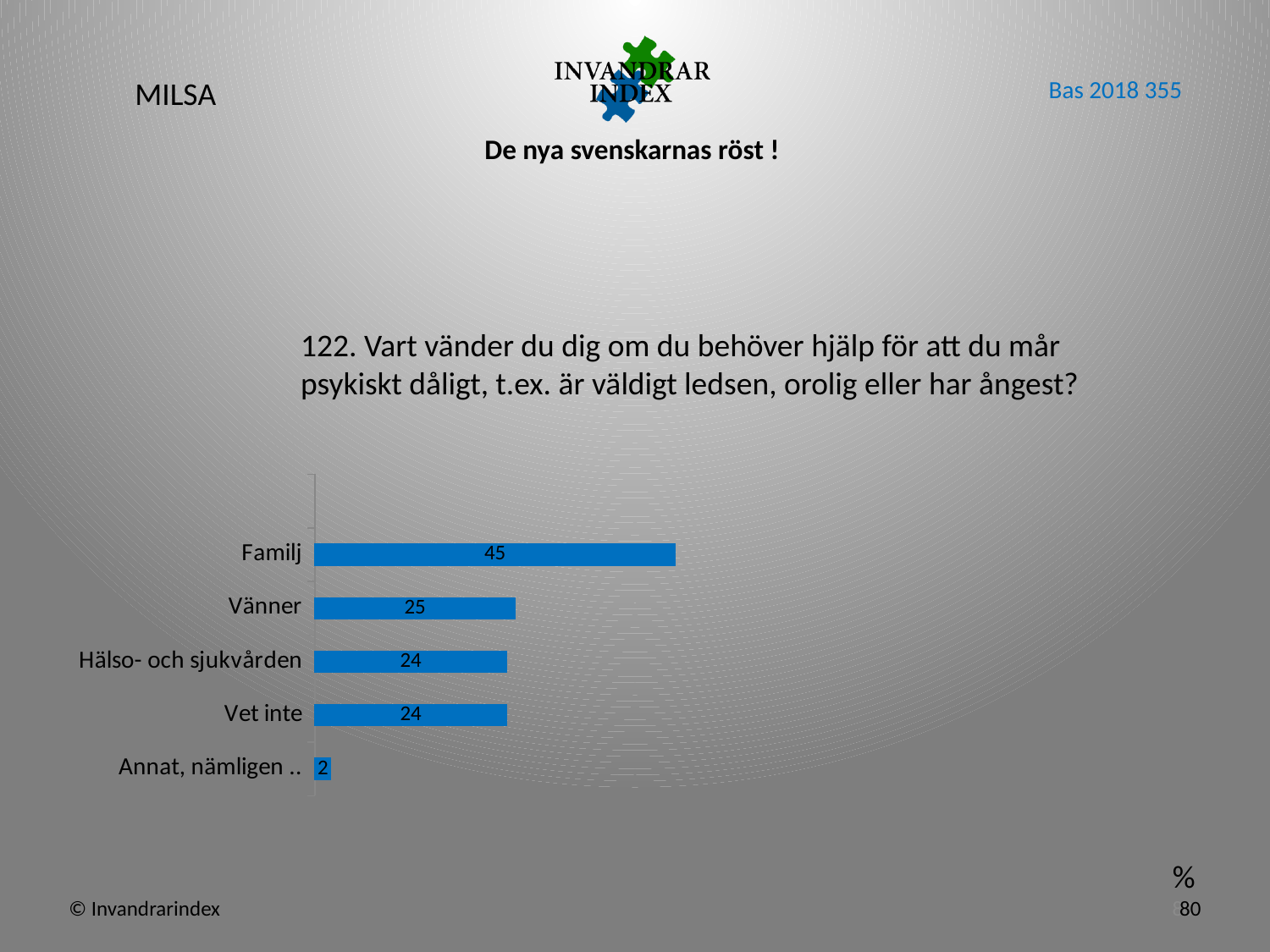
What is the value for Annat, nämligen ..? 2 What is the value for Vänner? 25 What is the difference between the values for Vet inte and Annat, nämligen ..? 22 What kind of chart is shown on the slide? bar chart What is the value for Hälso- och sjukvården? 24 What is the difference between the values for Familj and Vänner? 20 Which is larger, the value for Familj or the value for Vet inte? Familj Which category has the highest value? Familj What colour are the bars in the chart? blue How many categories are shown in the chart? 5 Which category has the lowest value? Annat, nämligen .. What is the value for Familj? 45